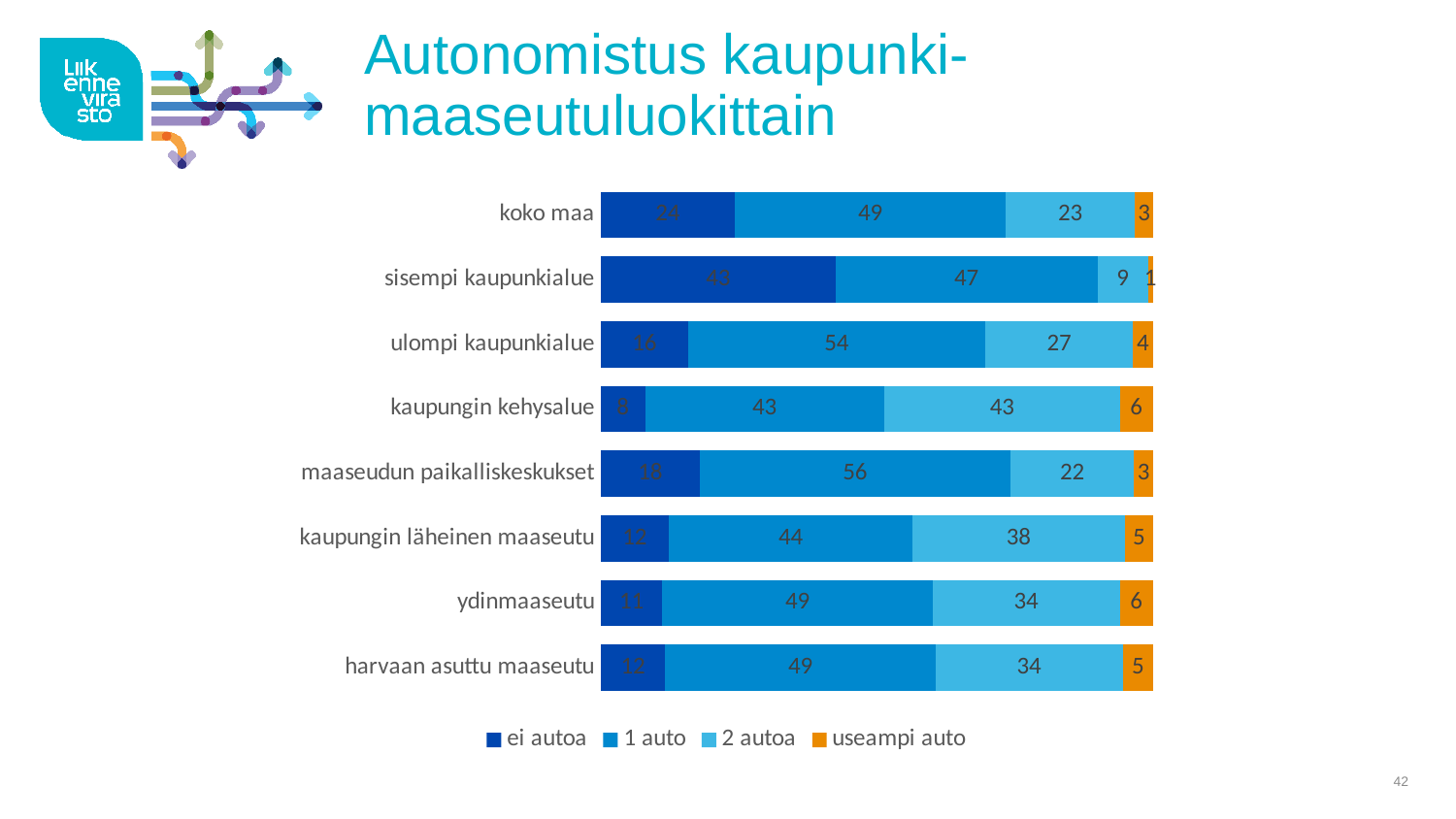
What kind of chart is shown on the slide? stacked bar chart How many series does the legend list? 4 What is the value of '2 autoa' for 'kaupungin kehysalue'? 43 What is the value of 'useampi auto' for 'sisempi kaupunkialue'? 1 What is the difference between the '2 autoa' values for 'kaupungin läheinen maaseutu' and 'ulompi kaupunkialue'? 11 How many categories (area types) are shown on the chart? 8 What is the value of '1 auto' for 'maaseudun paikalliskeskukset'? 56 Which category has the highest '1 auto' value? maaseudun paikalliskeskukset Which category has the lowest '2 autoa' value? sisempi kaupunkialue What is the value of '2 autoa' for 'koko maa'? 23 Which is larger: the '1 auto' value for 'ulompi kaupunkialue' or for 'kaupungin kehysalue'? ulompi kaupunkialue Which legend entry is shown in orange? useampi auto